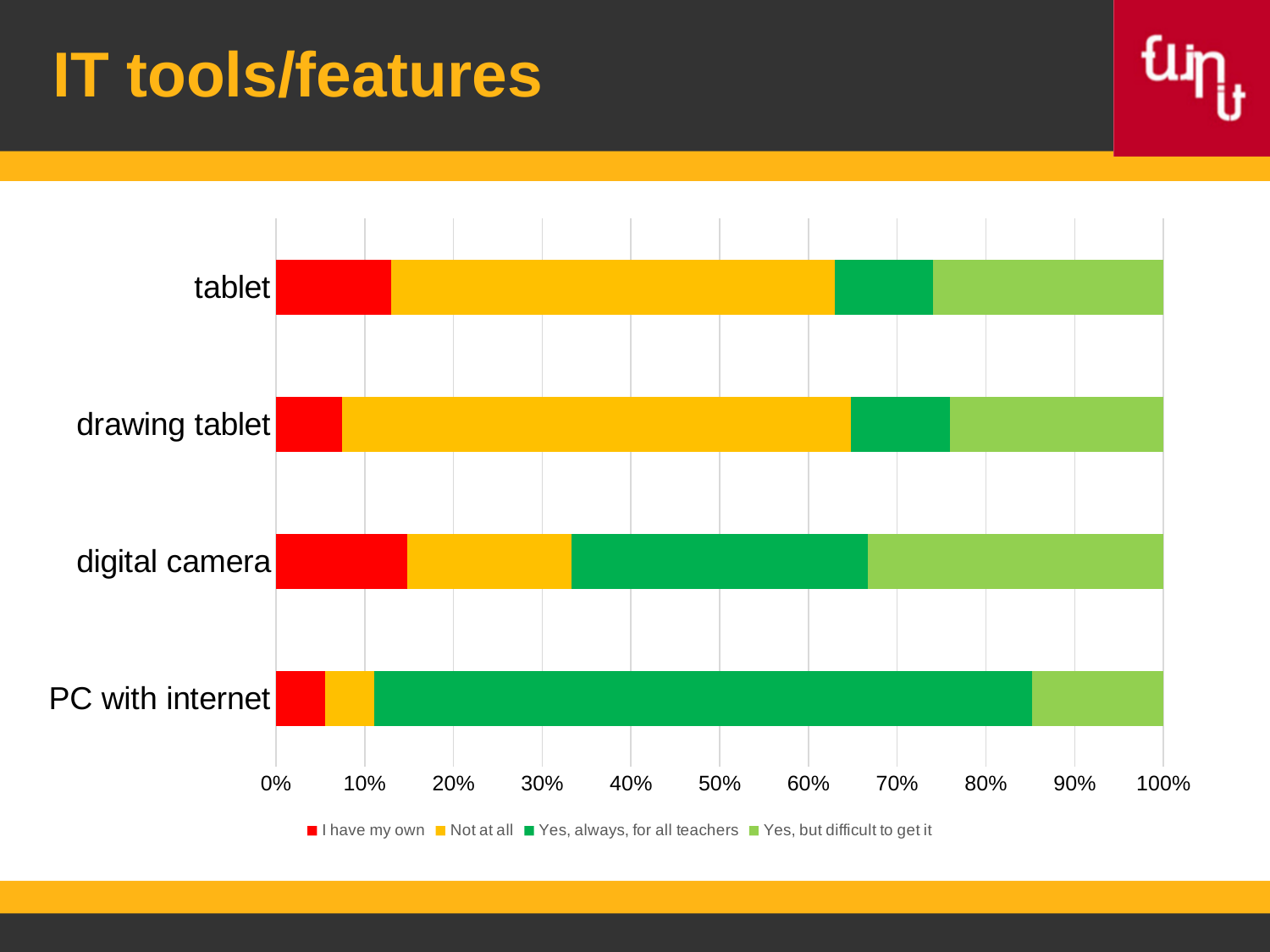
Is the 'Not at all' share for PC with internet greater or less than 10%? less Which legend entry is shown in red? I have my own What kind of chart is shown on the slide? Stacked bar chart Is the 'Yes, always, for all teachers' share for PC with internet greater or less than 70%? greater What is the title of the slide containing the chart? IT tools/features Which category has the largest 'Yes, always, for all teachers' segment? PC with internet Which category has the largest 'Not at all' segment? drawing tablet How many series does the legend list? 4 How many categories (IT tools) are plotted on the chart? 4 What is the total of the stacked bar for tablet? 100% Is the 'I have my own' share for digital camera greater or less than 10%? greater Which has a larger 'Not at all' segment: tablet or digital camera? tablet